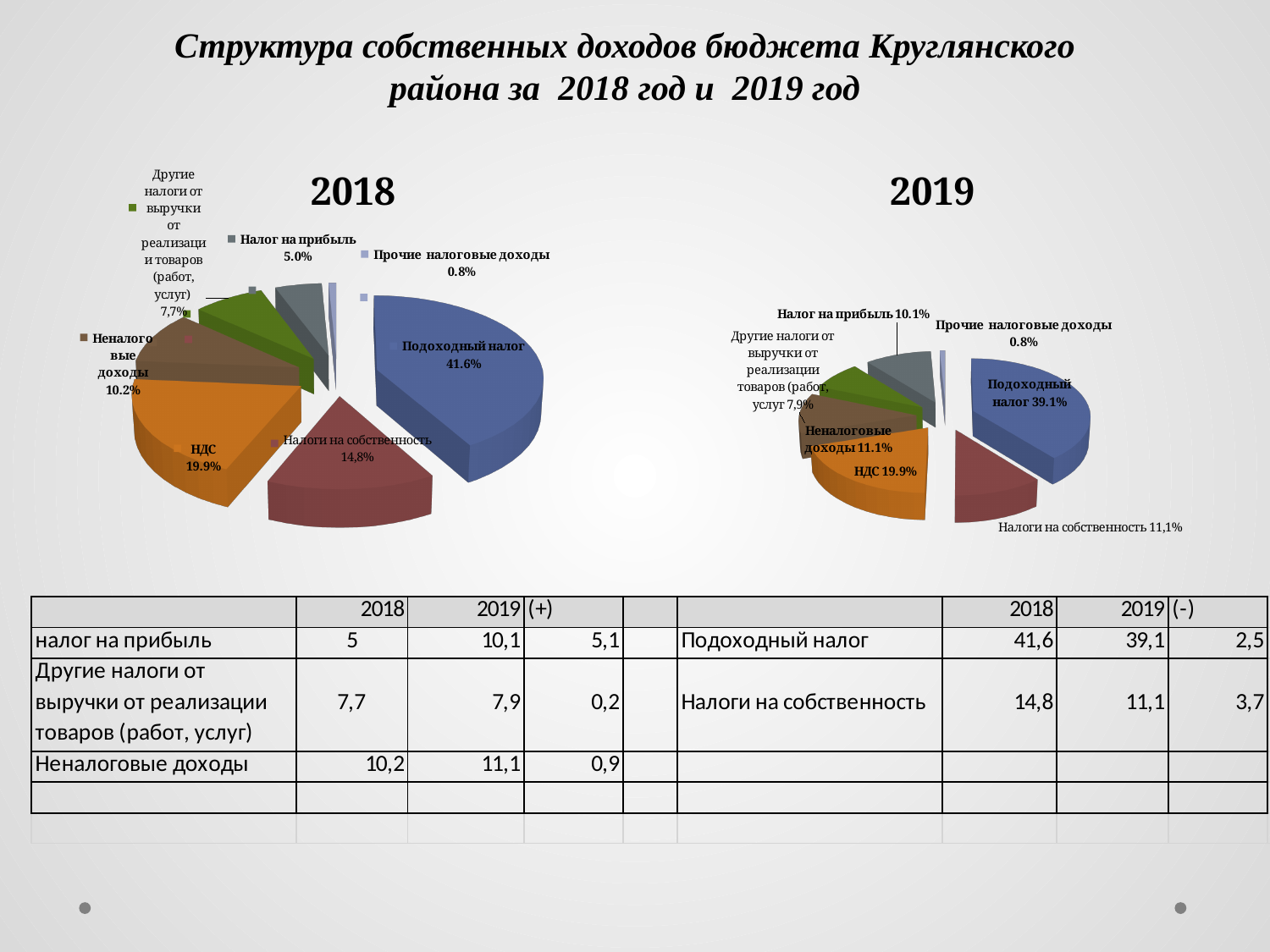
In the 2019 pie chart, which is larger: НДС or Неналоговые доходы? НДС In the 2018 pie chart, which category has the largest slice? Подоходный налог How many slices does the 2018 pie chart have? 7 In the 2019 pie chart, what share does Подоходный налог have? 39.1% In the 2018 pie chart, what is the value for НДС? 19.9% In the 2019 pie chart, what is the value for Налог на прибыль? 10.1% In the 2018 pie chart, what is the difference between the shares of Подоходный налог and НДС? 21.7% In the 2018 pie chart, which category has the smallest slice? Прочие налоговые доходы In the 2019 pie chart, which category has the smallest slice? Прочие налоговые доходы In the 2018 pie chart, what share does Подоходный налог have? 41.6% What type of chart is used for the 2019 data? Pie chart In the 2018 pie chart, what is the value for Налоги на собственность? 14,8%